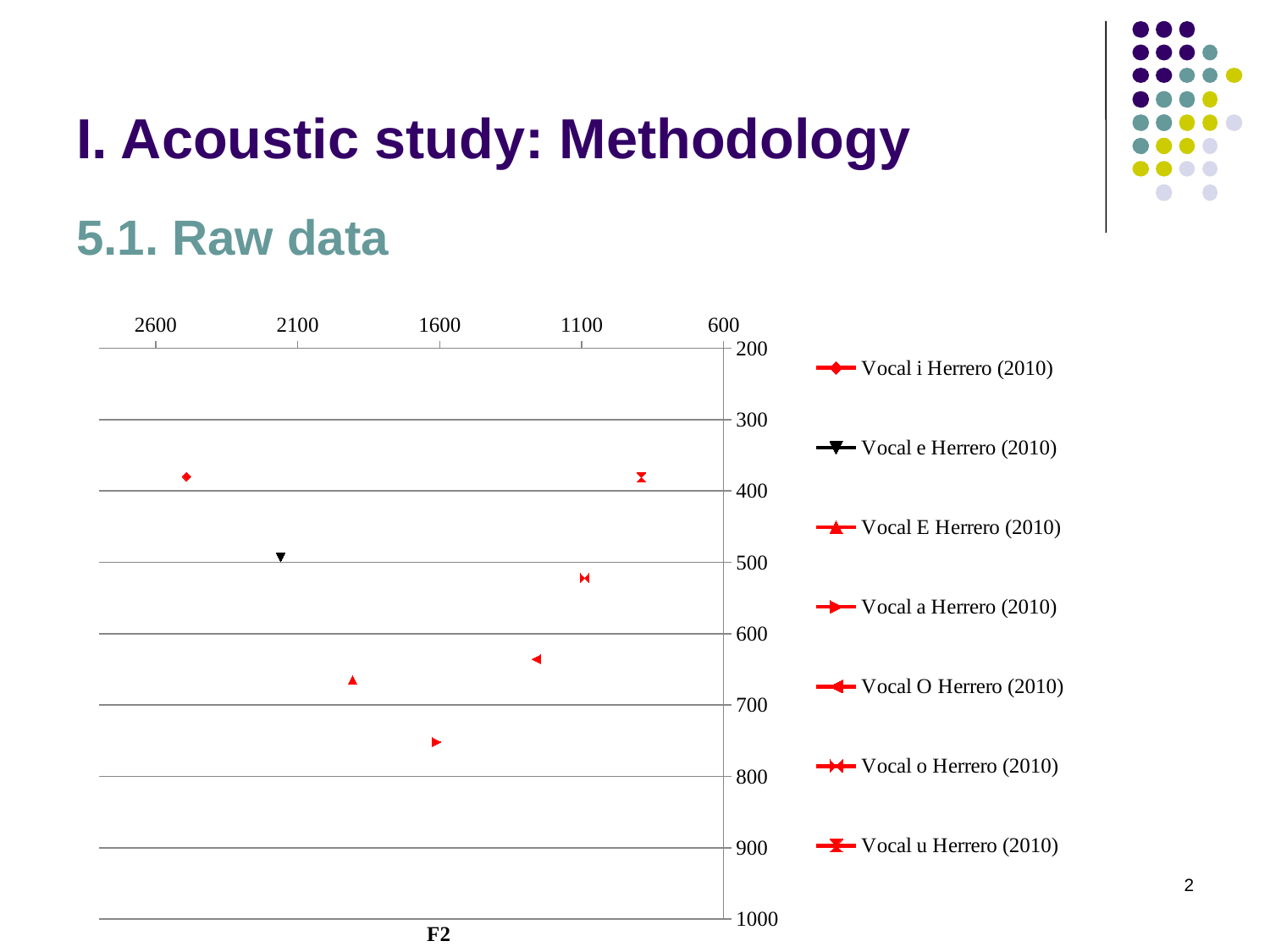
Is the vertical-axis value for Vocal a Herrero (2010) greater or less than 700? greater Is the vertical-axis value for Vocal u Herrero (2010) greater or less than 500? less Which series has the highest value on the vertical axis? Vocal a Herrero (2010) What is the title of the horizontal axis? F2 How many data points are plotted on the chart? 7 Which year is cited in every legend entry? 2010 Is the F2 value for Vocal i Herrero (2010) greater or less than 2100? greater What kind of chart is shown on the slide? scatter chart Which series has the highest F2 value? Vocal i Herrero (2010) Which series has the lowest F2 value? Vocal u Herrero (2010) Which has the larger vertical-axis value, Vocal E Herrero (2010) or Vocal o Herrero (2010)? Vocal E Herrero (2010) How many series does the legend list? 7